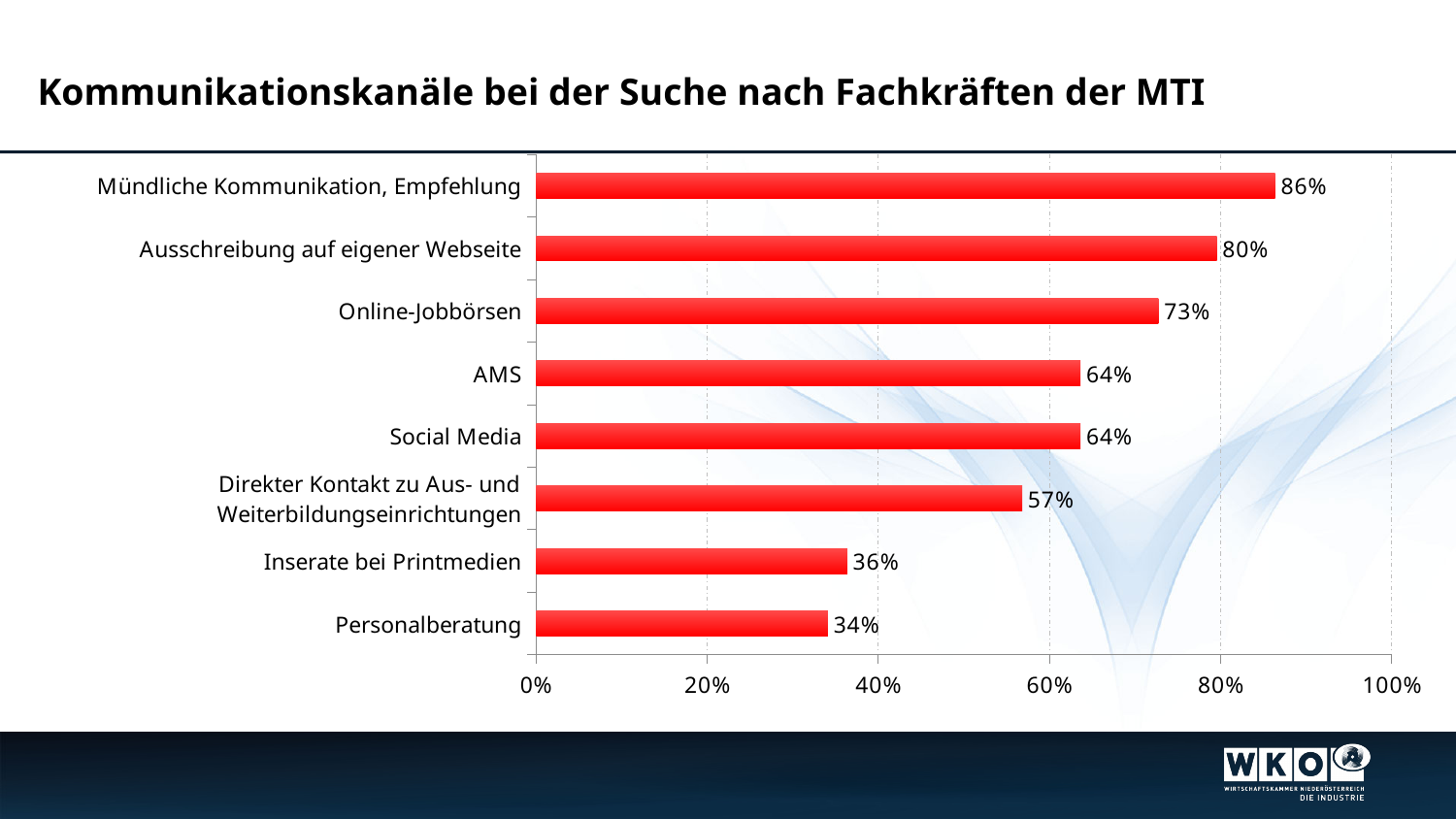
Which category has the lowest value? Personalberatung What is the difference between the values for Ausschreibung auf eigener Webseite and Personalberatung? 46% What is the title of the slide? Kommunikationskanäle bei der Suche nach Fachkräften der MTI Which category has the highest value? Mündliche Kommunikation, Empfehlung What is the value for Online-Jobbörsen? 73% How many categories are shown in the chart? 8 What is the value for Inserate bei Printmedien? 36% What kind of chart is shown on the slide? Bar chart Which is larger, the value for AMS or the value for Inserate bei Printmedien? AMS Is the value for Social Media greater or less than 60%? greater What is the value for Direkter Kontakt zu Aus- und Weiterbildungseinrichtungen? 57% What is the value for Mündliche Kommunikation, Empfehlung? 86%